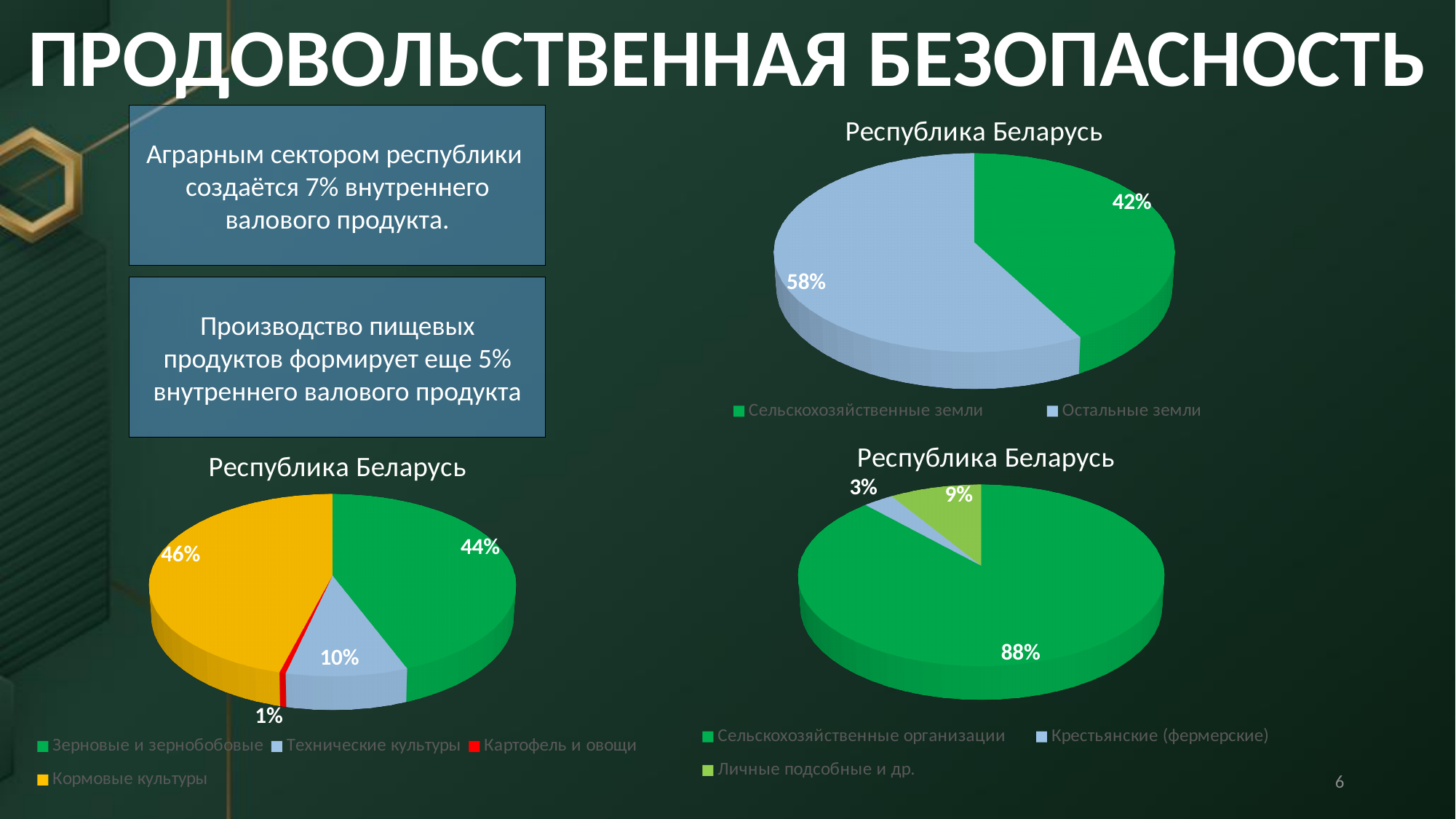
In the bottom-right pie chart, what share is labelled for Крестьянские (фермерские)? 3% In the bottom-left pie chart, what share is labelled for Технические культуры? 10% In the bottom-left pie chart, how many categories does the legend list? 4 In the top-right pie chart, which category has the larger share? Остальные земли In the bottom-right pie chart, what is the difference between the shares of Личные подсобные и др. and Крестьянские (фермерские)? 6% In the bottom-left pie chart, which category has the smallest share? Картофель и овощи In the bottom-left pie chart, what share is labelled for Картофель и овощи? 1% In the bottom-left pie chart, which category has the largest share? Кормовые культуры In the bottom-right pie chart, what share is labelled for Сельскохозяйственные организации? 88% In the top-right pie chart, what share is labelled for Сельскохозяйственные земли? 42% In the top-right pie chart, what share is labelled for Остальные земли? 58% What type of chart is the top-right chart on the slide? Pie chart